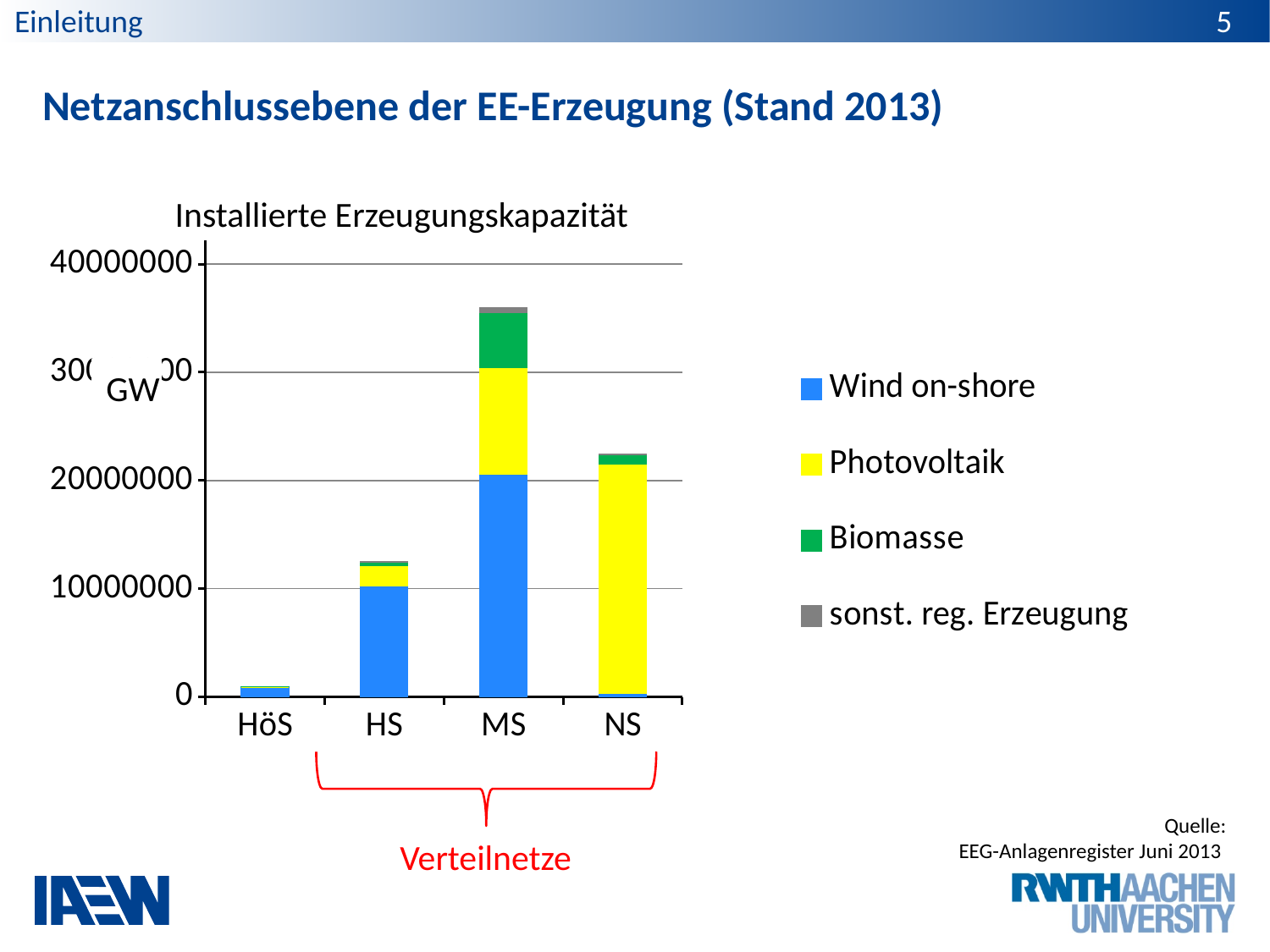
How many series does the legend list? 4 Which has a larger total bar, HS or HöS? HS Is the total value for HöS greater or less than 10000000? less Which category has the highest total installed capacity? MS Is the total value for MS greater or less than 30000000? greater Which category has the lowest total installed capacity? HöS Which has a larger total bar, MS or NS? MS Is the total value for NS greater or less than 20000000? greater What kind of chart is shown on the slide? Stacked bar chart Which series is shown in yellow in the legend? Photovoltaik How many categories are shown on the x axis of the chart? 4 What is the title of the chart? Installierte Erzeugungskapazität